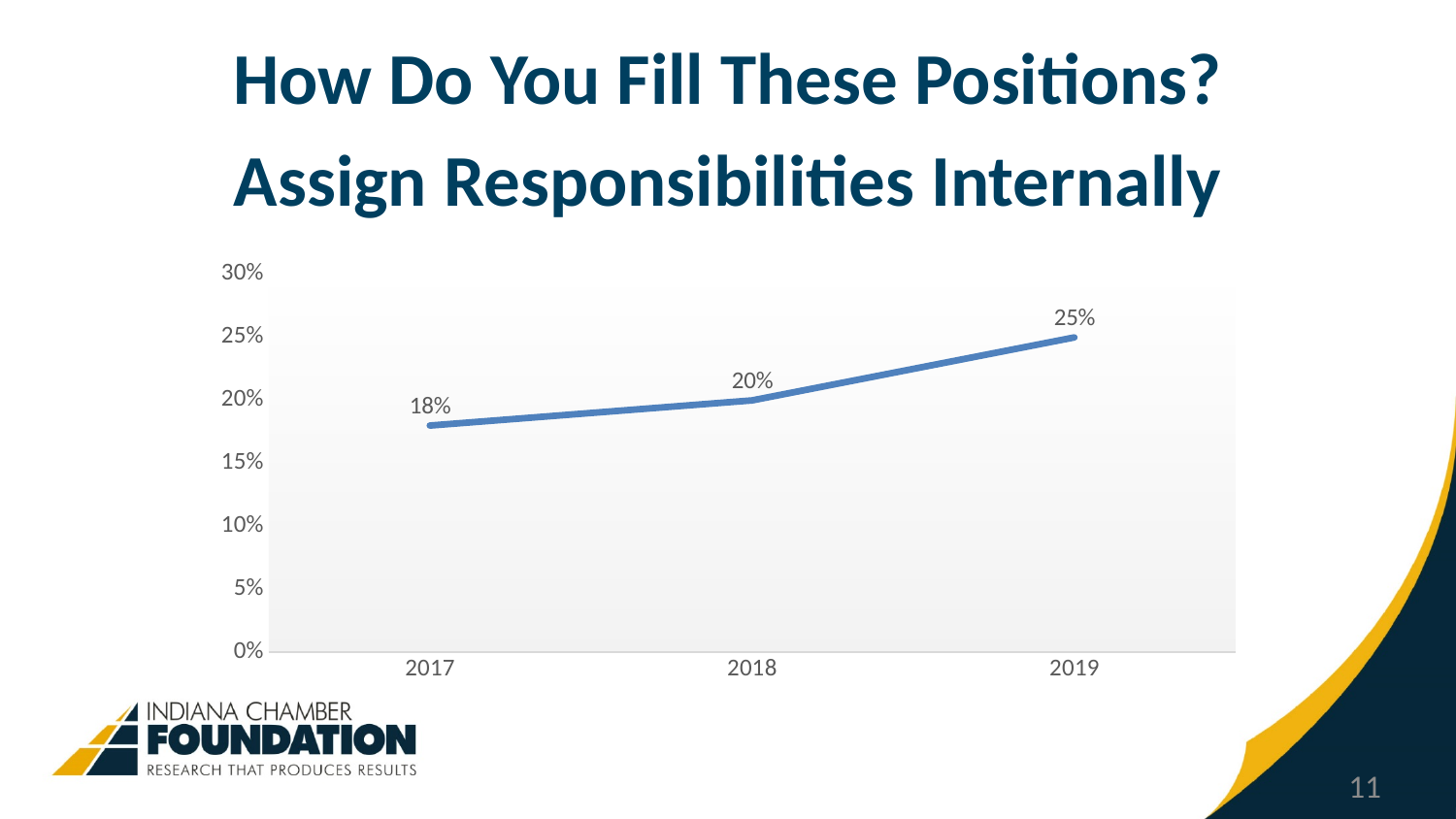
Which year has the lowest value? 2017 What is the difference between the values for 2019 and 2017? 7% What is the value for 2017? 18% What is the value for 2018? 20% Is the value for 2019 greater or less than 20%? greater What kind of chart is shown on the slide? line chart What is the value for 2019? 25% Which year has the highest value? 2019 What is the difference between the values for 2018 and 2017? 2% Do the values rise or fall from 2017 to 2019? rise How many years are plotted on the chart? 3 Which is larger, the value for 2018 or the value for 2019? 2019